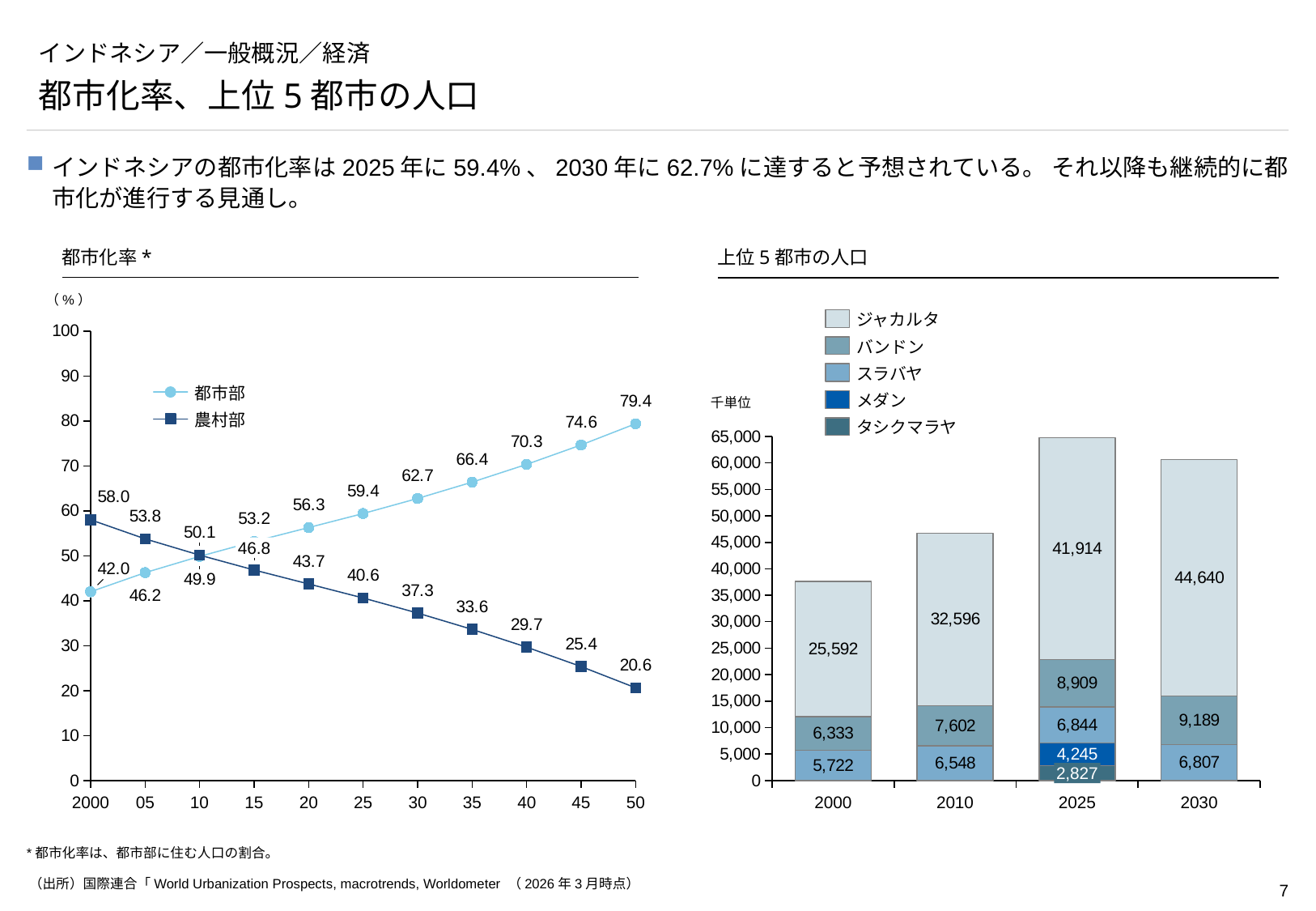
In the 上位5都市の人口 chart, what is the value for ジャカルタ in 2030? 44,640 In the 上位5都市の人口 chart, what is the value for メダン in 2025? 4,245 In the 都市化率 chart, what is the value for 農村部 in 2000? 58.0 In the 上位5都市の人口 chart, how many cities does the legend list? 5 In the 上位5都市の人口 chart, which is larger, バンドン in 2025 or バンドン in 2030? バンドン in 2030 In the 都市化率 chart, how many series does the legend list? 2 In the 都市化率 chart, what is the value for 都市部 in 2025? 59.4 In the 上位5都市の人口 chart, what is the total of the 2000 bar? 37,647 What kind of chart is the 上位5都市の人口 chart? stacked bar chart In the 都市化率 chart, does the 農村部 series rise or fall from 2000 to 2050? fall In the 都市化率 chart, what is the difference between 都市部 and 農村部 in 2050? 58.8 In the 都市化率 chart, how many years are plotted on the x axis? 11